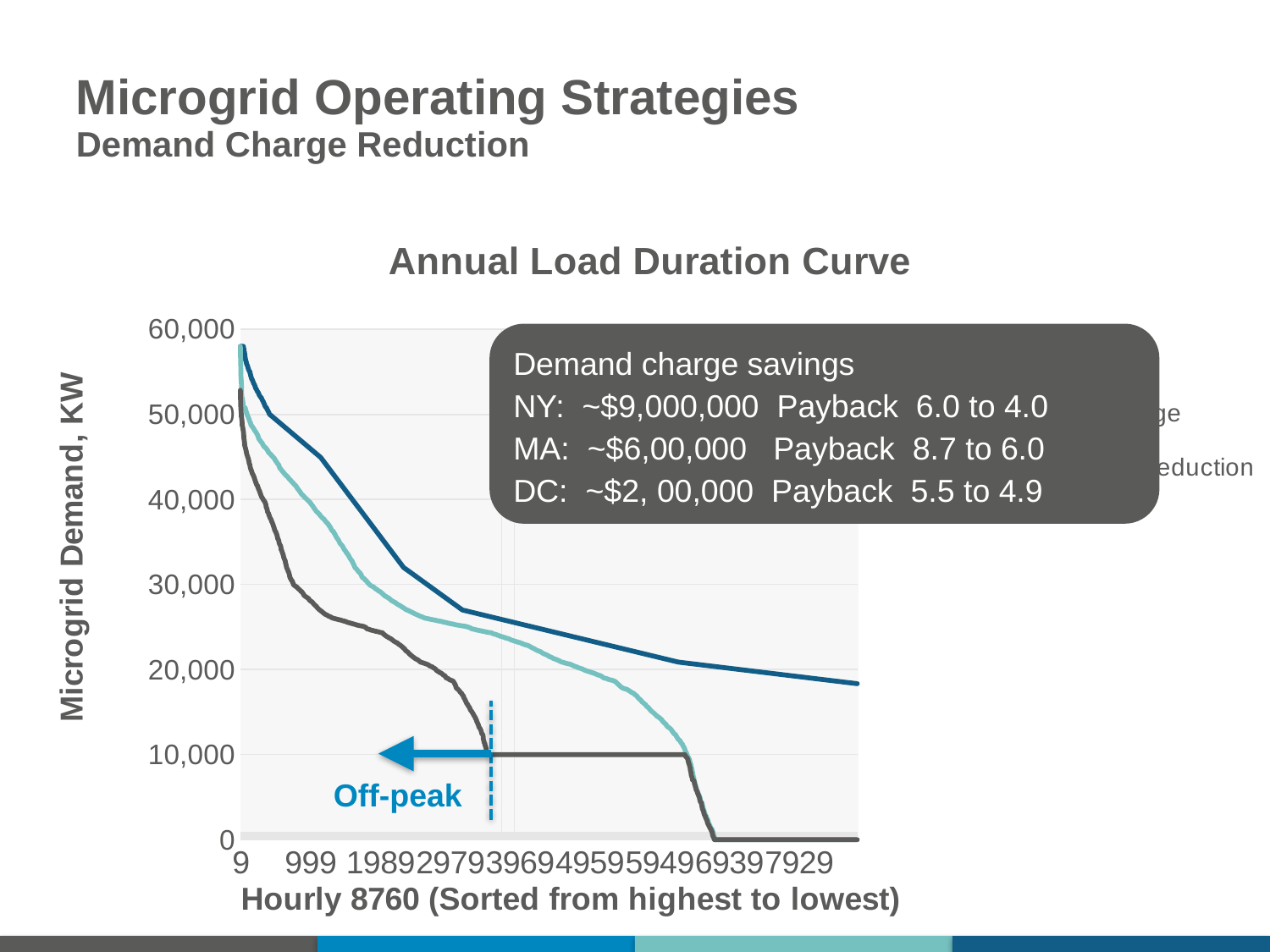
What is the label on the vertical axis of the chart? Microgrid Demand, KW Is the value of the teal line at x = 999 greater or less than 40,000? greater At the far right end of the chart, which line is higher: the dark blue line or the gray line? dark blue line What kind of chart is shown on the slide? line chart What is the highest tick value shown on the vertical axis? 60,000 At what demand level does the flat horizontal segment of the gray line sit? 10,000 How many lines are plotted on the chart? 3 Is the value of the dark blue line at the far right end of the chart greater or less than 20,000? less Is the starting value of the dark blue line at the left edge greater or less than 60,000? less What is the title of the chart? Annual Load Duration Curve What value does the gray line reach at the far right of the chart? 0 Do the plotted values rise or fall moving left to right along the x axis? fall